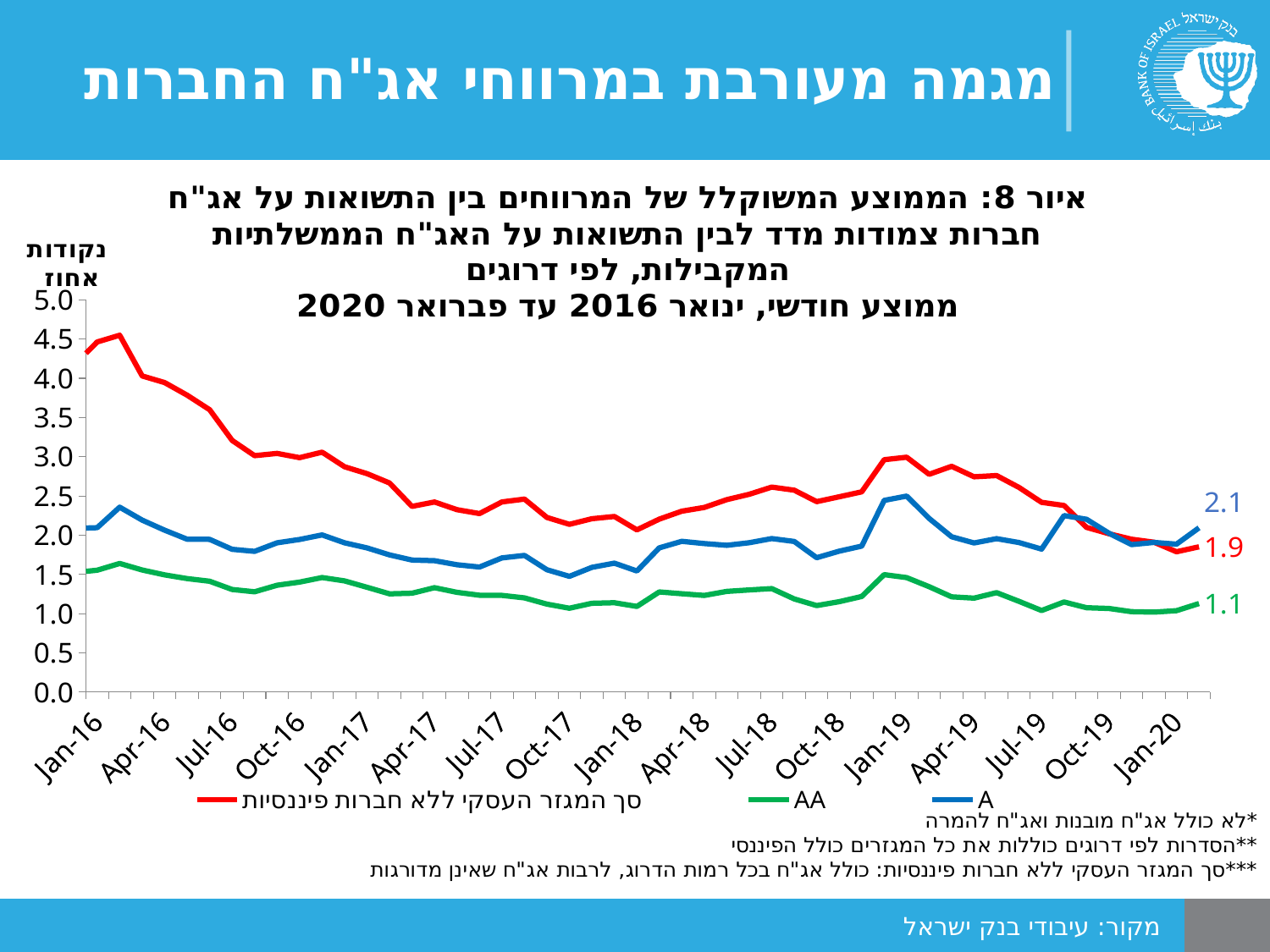
What kind of chart is shown on the slide? line chart At the end of the period, which is larger: the labelled value of the A series or of the red series (סך המגזר העסקי ללא חברות פיננסיות)? A Is the value of the AA series at Jan-16 greater or less than 2.0? less Which series has the highest value at Jan-16? סך המגזר העסקי ללא חברות פיננסיות What is the value labelled at the end of the A series (blue line)? 2.1 What is the value labelled at the end of the red series (סך המגזר העסקי ללא חברות פיננסיות)? 1.9 Which series has the lowest values throughout the chart? AA Is the value of the red series at Jan-16 greater or less than 4.0? greater Does the red series (סך המגזר העסקי ללא חברות פיננסיות) overall rise or fall from Jan-16 to Jan-20? fall What is the value labelled at the end of the AA series (green line)? 1.1 How many series does the legend list? 3 What is the difference between the end-of-period labelled values of the A series and the AA series? 1.0